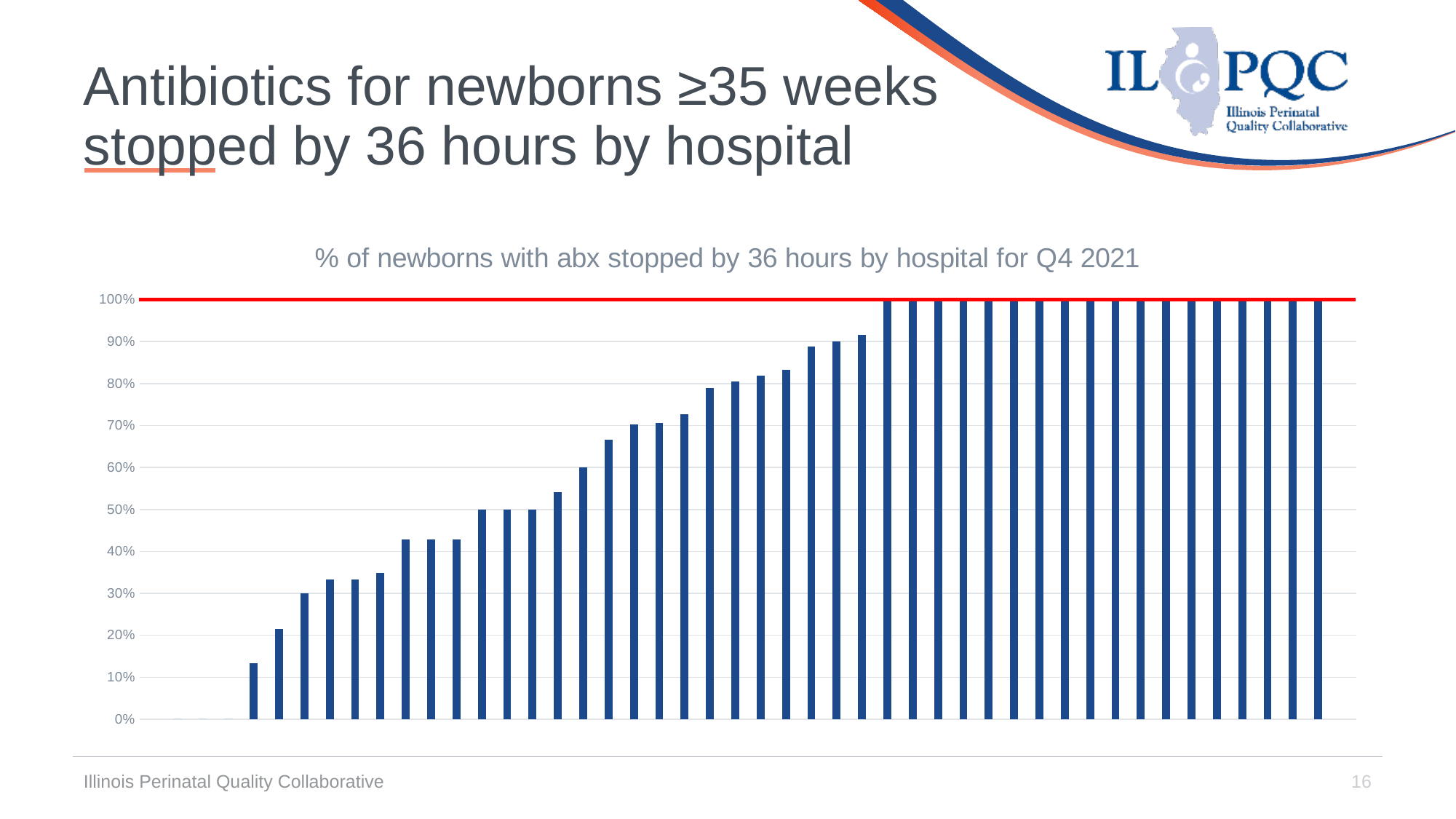
Which is larger, the value of the leftmost non-zero bar or the value of the rightmost bar? the rightmost bar Is the value of the leftmost non-zero bar greater or less than 20%? less What is the title of the chart? % of newborns with abx stopped by 36 hours by hospital for Q4 2021 Do the bar values rise or fall from left to right across the chart? rise At what value is the red horizontal line drawn across the chart? 100% Is the value of the rightmost bar greater or less than 90%? greater Is the value of the second non-zero bar from the left greater or less than 30%? less What kind of chart is shown on the slide? bar chart What is the maximum value shown on the vertical axis? 100% What is the highest value reached by the bars in the chart? 100%